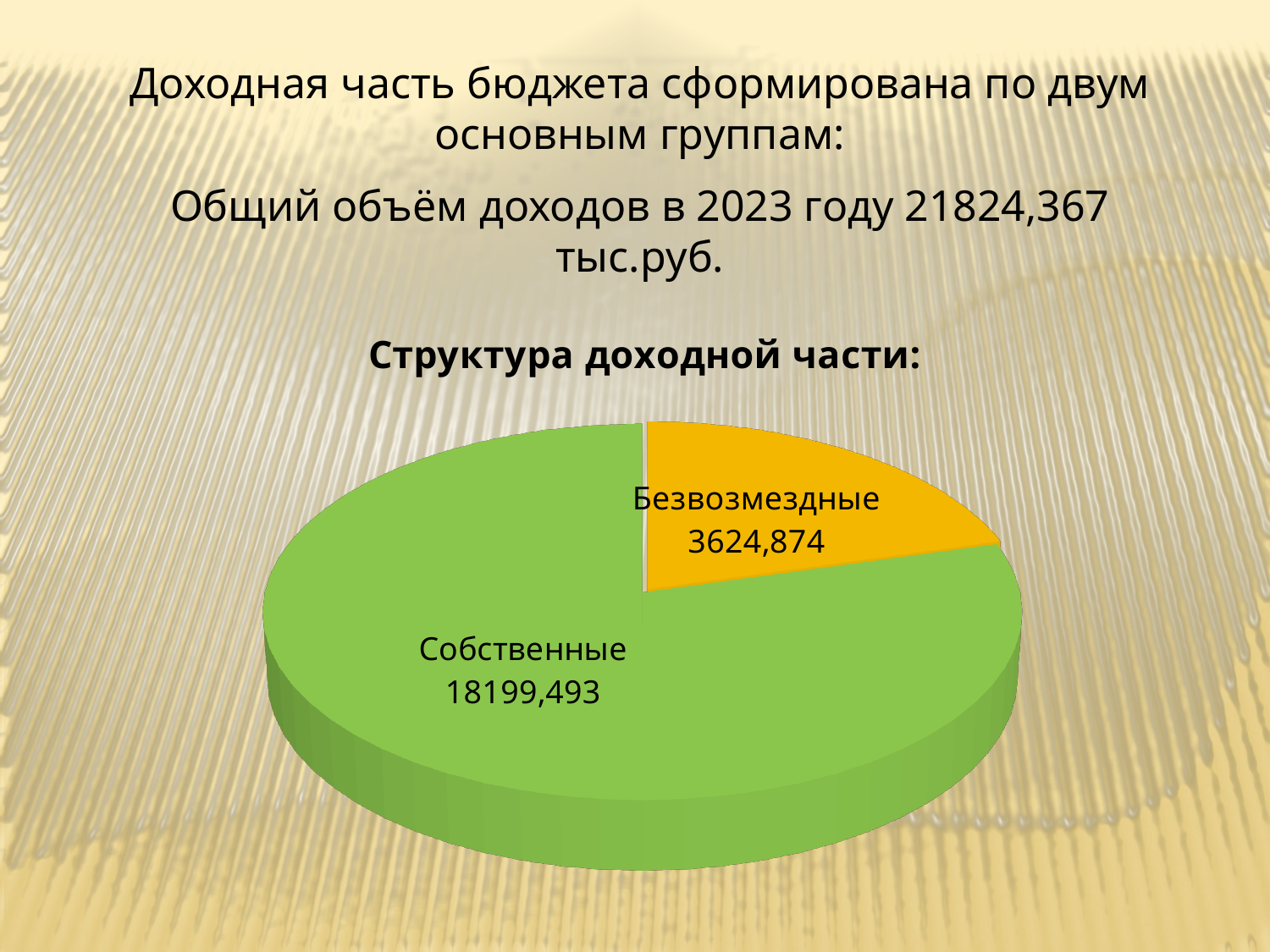
What is the value for Безвозмездные in the pie chart? 3624,874 What is the title of the pie chart? Структура доходной части: What is the difference between the values for Собственные and Безвозмездные? 14574,619 What colour is the Безвозмездные slice in the pie chart? Orange (yellow-orange) Which is larger, Собственные or Безвозмездные? Собственные Which slice of the pie chart is the smallest? Безвозмездные What type of chart is shown on the slide? Pie chart How many slices does the pie chart have? 2 Which slice of the pie chart is the largest? Собственные What is the total of the two slices in the pie chart? 21824,367 What is the value for Собственные in the pie chart? 18199,493